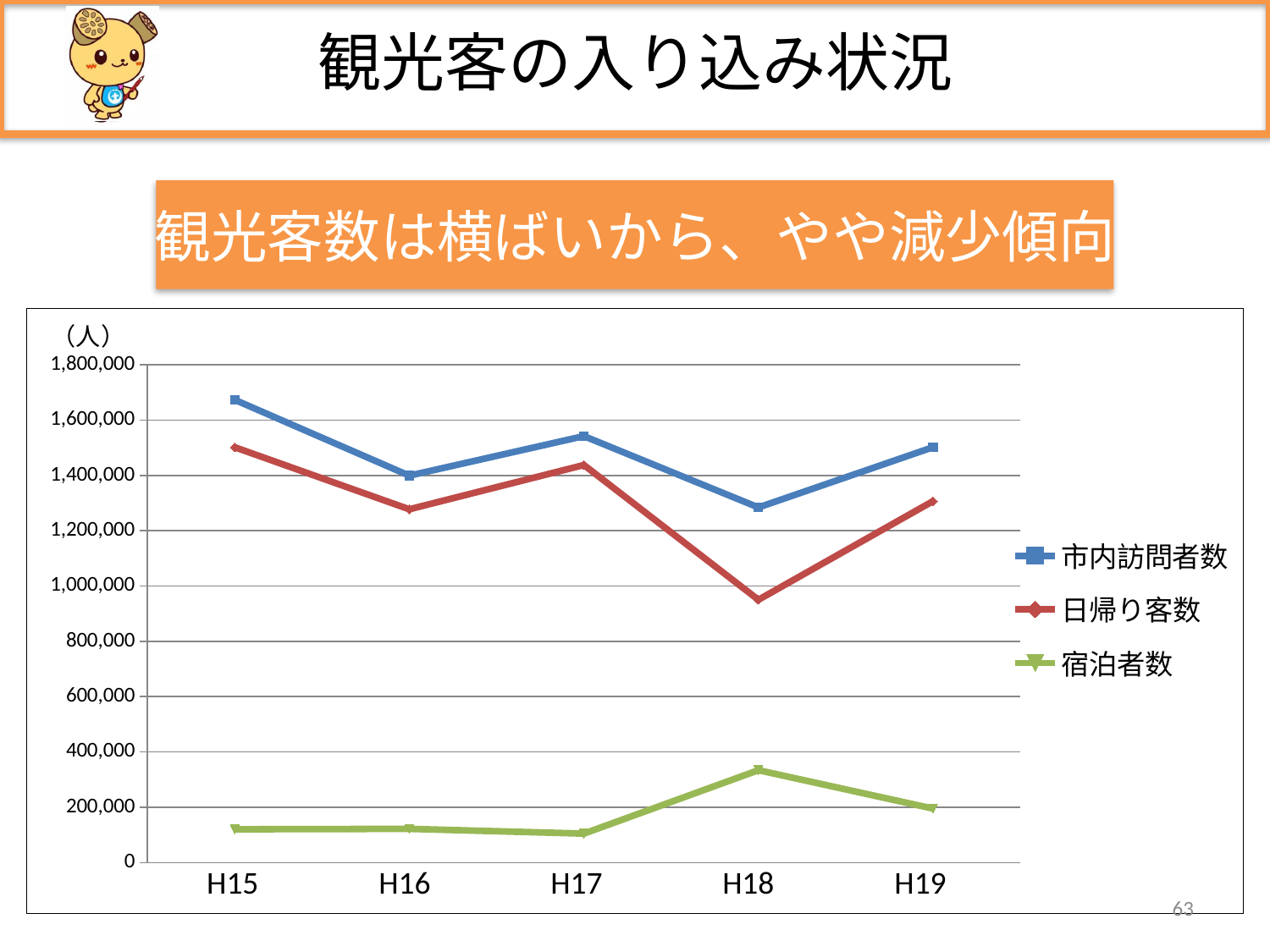
In which year is 市内訪問者数 highest? H15 How many years are shown along the x axis? 5 What unit is shown at the top of the y axis? （人） How many series does the legend list? 3 Is the value for 市内訪問者数 in H15 greater or less than 1,600,000? greater In H18, which is larger: 市内訪問者数 or 日帰り客数? 市内訪問者数 In which year is 日帰り客数 lowest? H18 In which year is 市内訪問者数 lowest? H18 What kind of chart is shown on the slide? line chart Does 宿泊者数 rise or fall from H17 to H18? rise In which year is 宿泊者数 highest? H18 Is the value for 日帰り客数 in H18 greater or less than 1,000,000? less